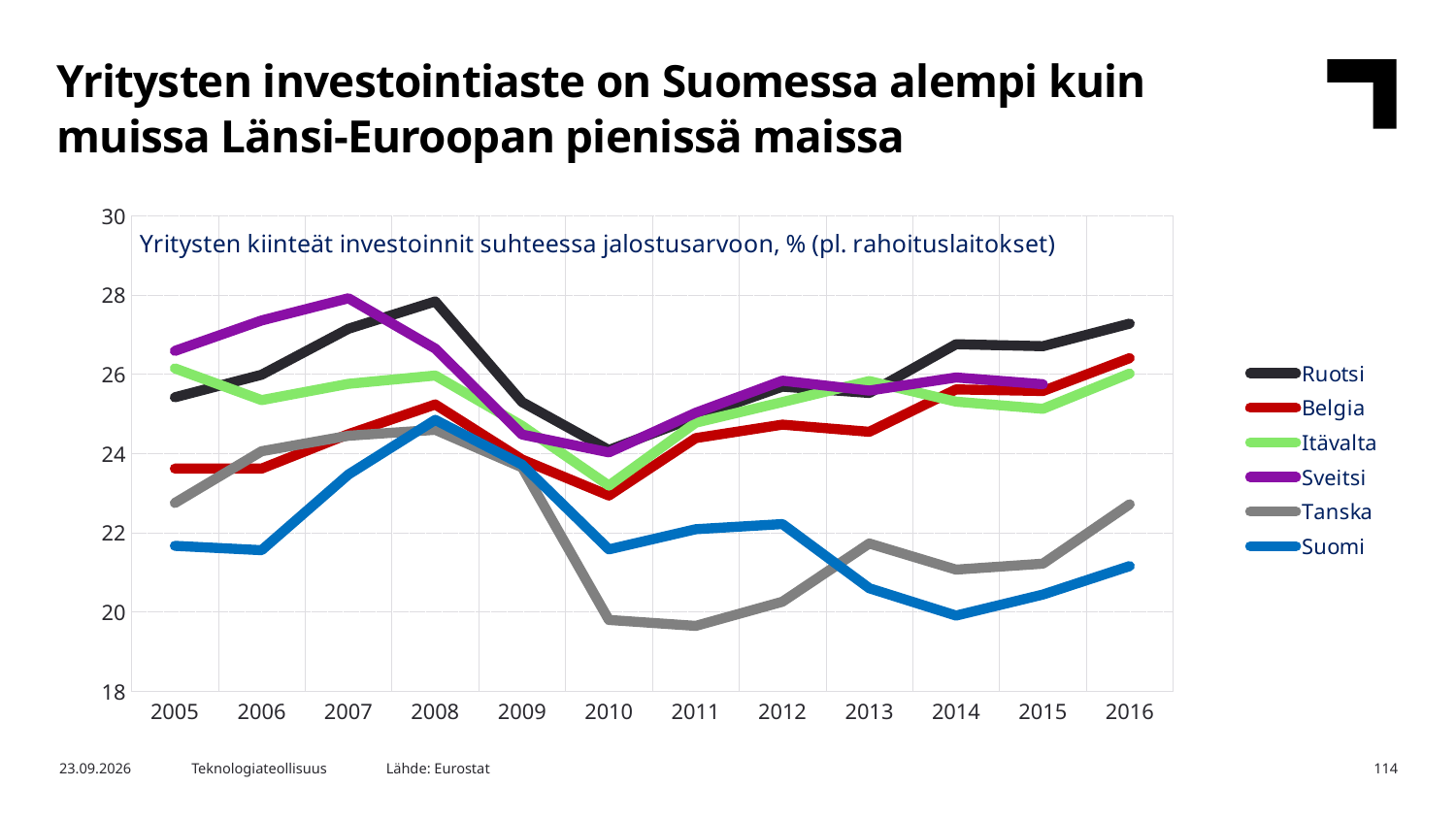
Which country has the highest value in 2016? Ruotsi How many years are shown on the x axis? 12 Is the value for Suomi in 2014 greater or less than 22? less Which country has the lowest value in 2011? Tanska Does the value for Ruotsi rise or fall from 2005 to 2008? Rise Is the value for Tanska in 2011 greater or less than 20? less Is the value for Ruotsi in 2008 greater or less than 26? greater Which country has the highest value in 2007? Sveitsi What colour is the line for Suomi? Blue How many series does the legend list? 6 In 2016, which is larger: the value for Ruotsi or the value for Suomi? Ruotsi What kind of chart is shown on the slide? Line chart